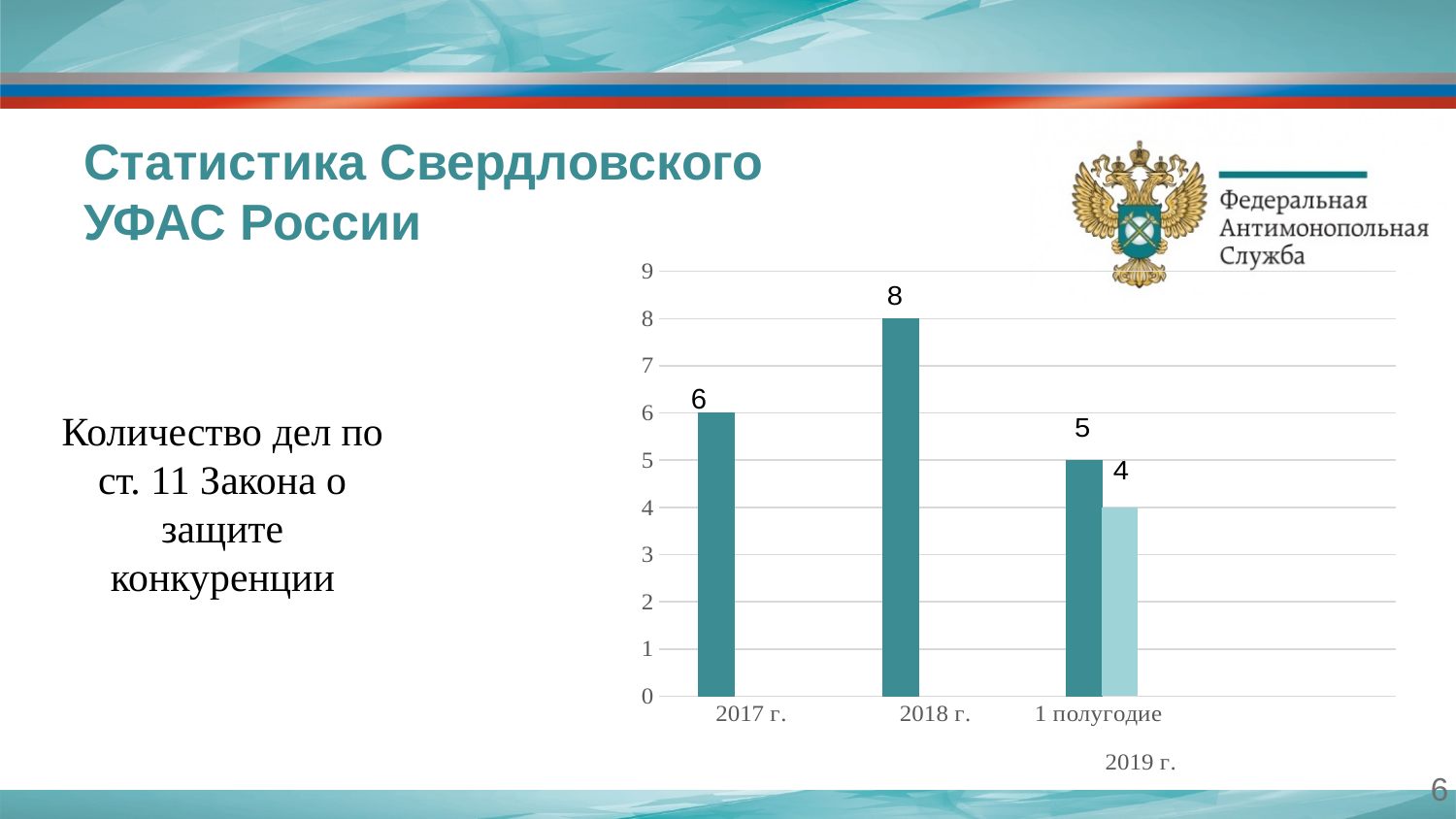
What is the value of the dark teal bar for 2018 г.? 8 Which category has the lowest dark teal bar? 1 полугодие 2019 г. What is the value of the dark teal bar for 1 полугодие 2019 г.? 5 What is the highest value shown on the y axis of the chart? 9 What kind of chart is shown on the slide? bar chart Which is larger: the dark teal bar for 2017 г. or the dark teal bar for 1 полугодие 2019 г.? 2017 г. How many categories are shown on the x axis of the chart? 3 What is the value of the light teal bar for 1 полугодие 2019 г.? 4 Does the dark teal bar rise or fall from 2017 г. to 2018 г.? rise What is the value of the dark teal bar for 2017 г.? 6 What is the difference between the dark teal bars for 2018 г. and 2017 г.? 2 Which category has the highest dark teal bar? 2018 г.